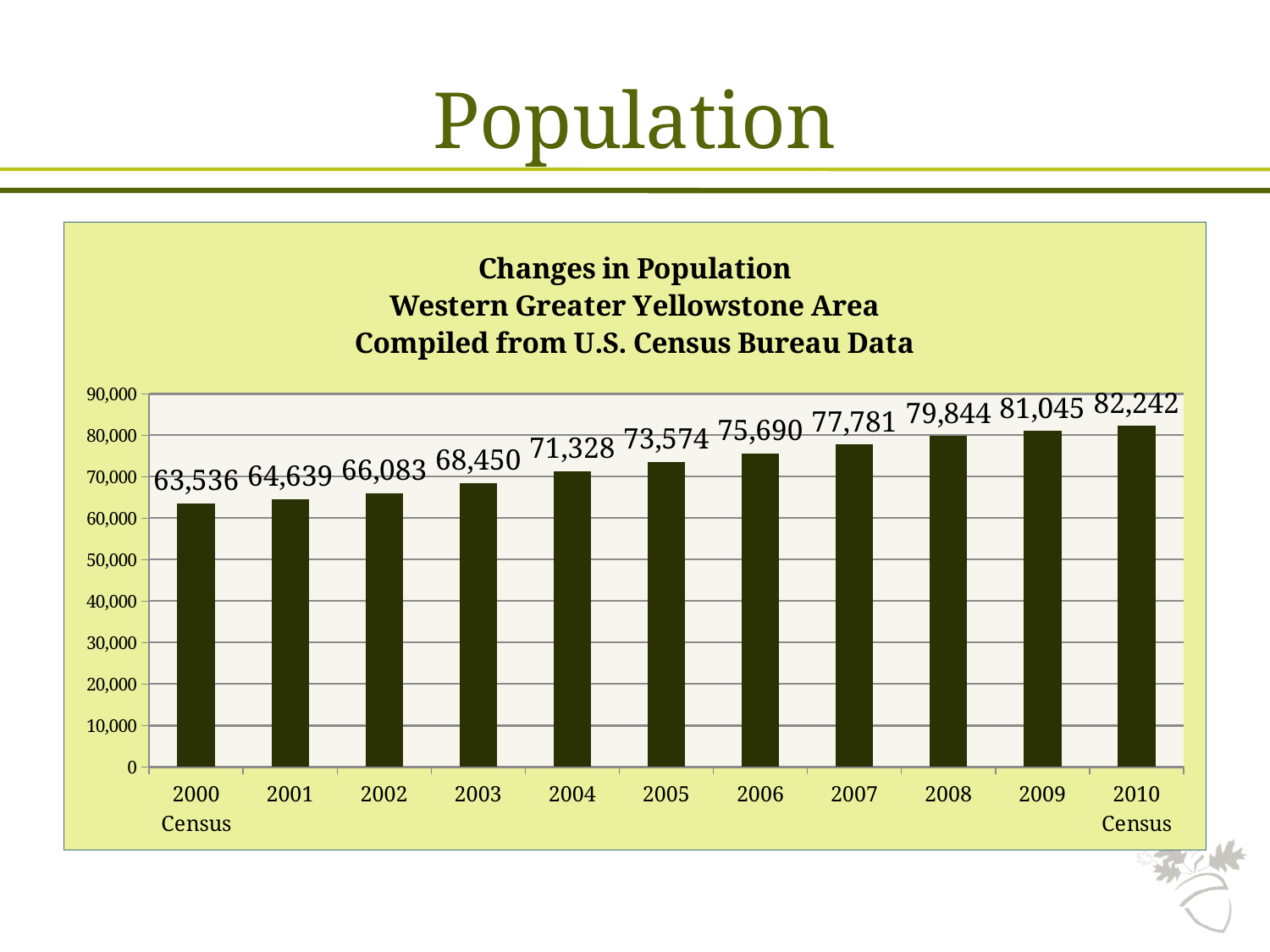
What was the population in 2005? 73,574 Which year had a larger population, 2006 or 2009? 2009 Which year has the highest population? 2010 What kind of chart is shown on the slide? Bar chart Is the population for 2007 greater or less than 70,000? greater By how much did the population increase from 2003 to 2004? 2,878 Does the population rise or fall from 2000 to 2010? Rise What is the difference in population between the 2010 Census and the 2000 Census? 18,706 What was the population in 2008? 79,844 Which year has the lowest population? 2000 How many years are shown on the chart? 11 What was the population in the 2000 Census? 63,536